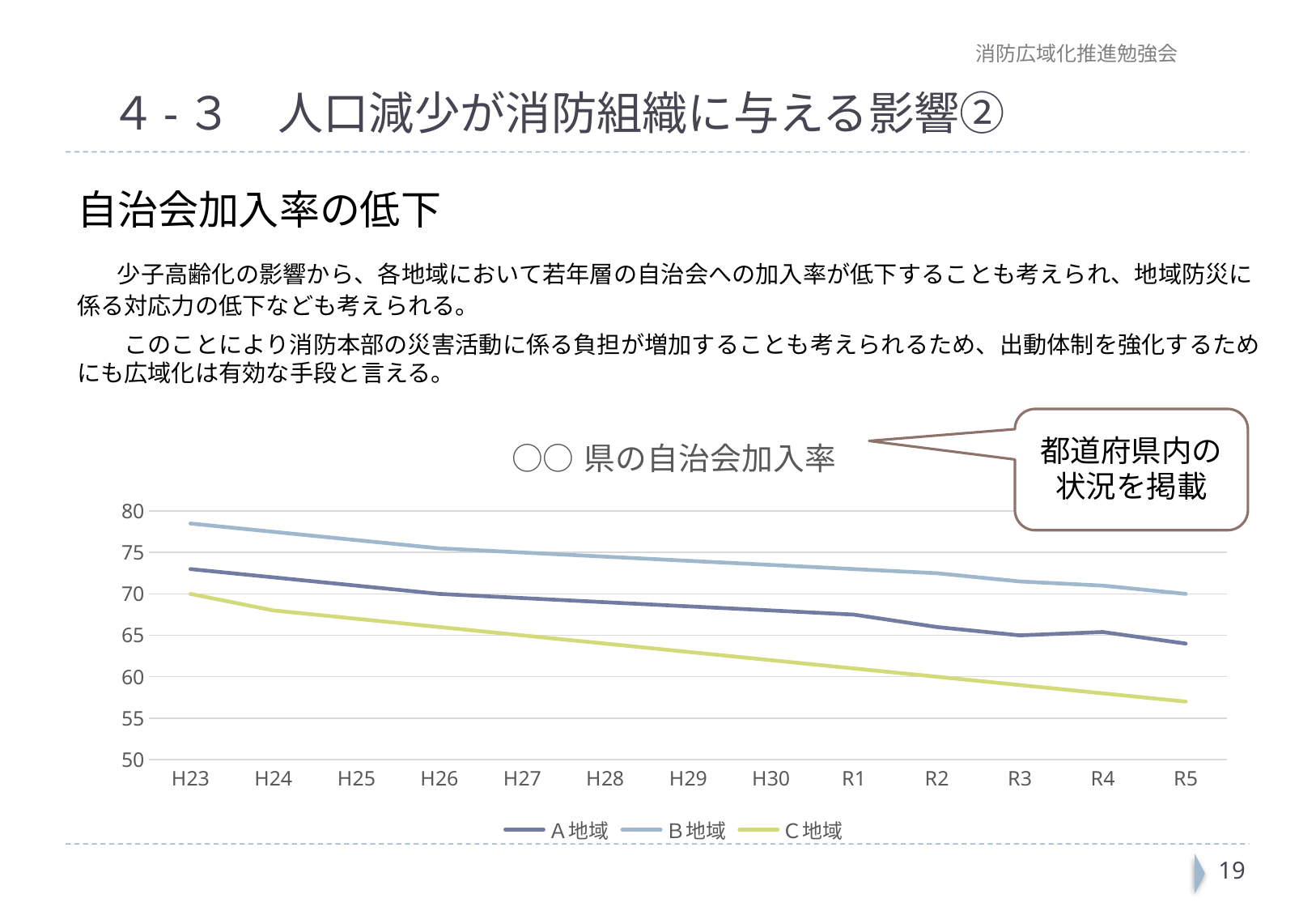
Which series is highest at H23? B地域 Do the values for C地域 rise or fall from H23 to R5? fall What kind of chart is shown on the slide? line chart What is the title of the chart? ○○県の自治会加入率 At R5, which is larger: the value for A地域 or the value for C地域? A地域 Is the value for C地域 at R5 greater or less than 60? less How many points are plotted along the x axis for each series? 13 How many series does the legend list? 3 Is the value for A地域 at R5 greater or less than 70? less Do the values for B地域 rise or fall along the x axis? fall Is the value for B地域 at H23 greater or less than 75? greater Which series is lowest at R5? C地域